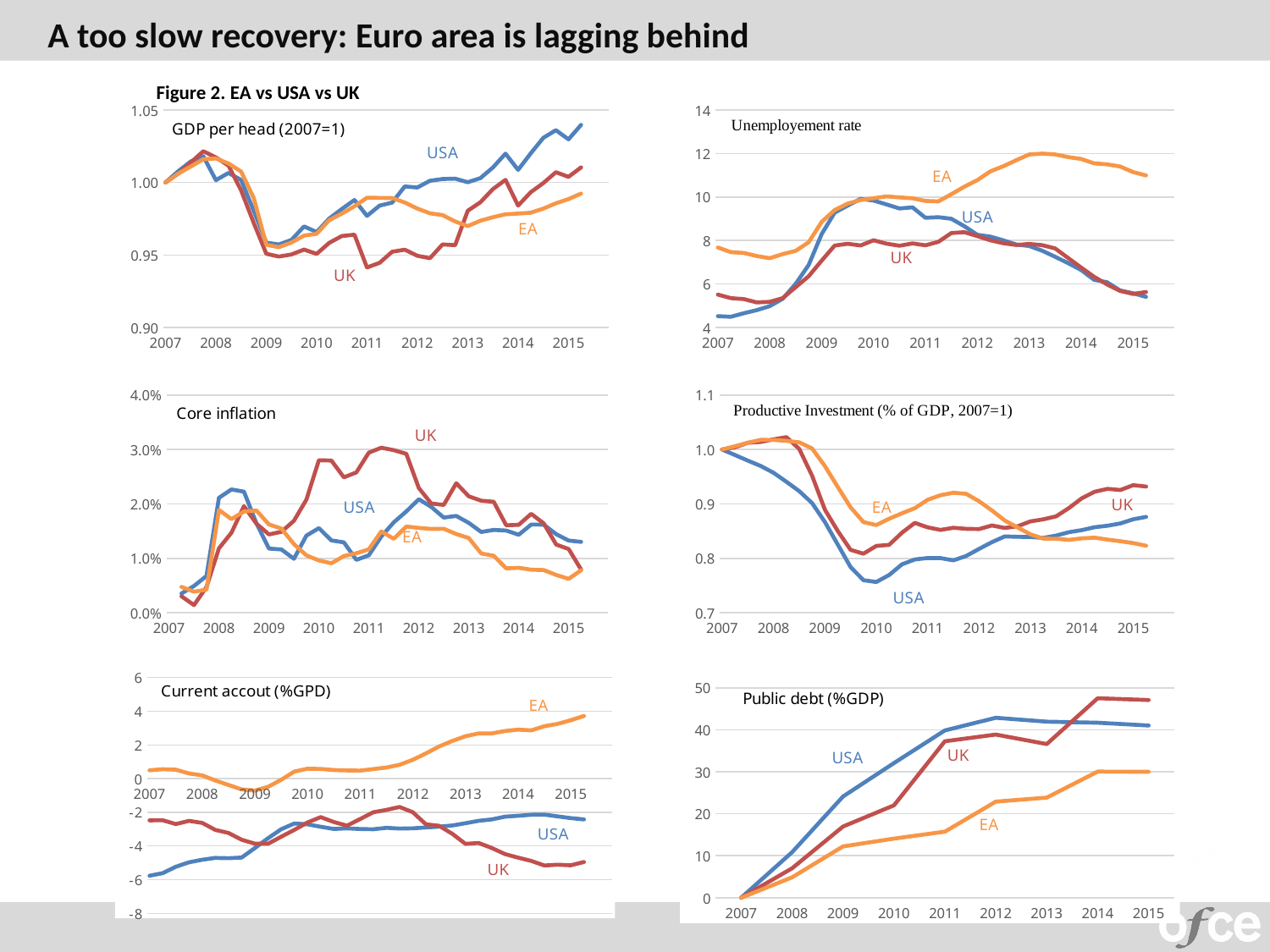
In the 'Unemployement rate' chart, which series is highest in 2013? EA What kind of chart is the 'GDP per head (2007=1)' chart? line chart In the 'Current accout (%GPD)' chart, is the value for EA in 2015 greater or less than 2? greater In the 'Unemployement rate' chart, is the value for EA in 2013 greater or less than 10? greater In the 'Core inflation' chart, which series reaches the highest peak? UK In the 'Public debt (%GDP)' chart, which series is highest in 2015? UK How many series are plotted in the 'GDP per head (2007=1)' chart? 3 In the 'Productive Investment (% of GDP, 2007=1)' chart, is the value for USA in 2010 greater or less than 0.8? less In the 'Current accout (%GPD)' chart, which series is lowest in 2015? UK In the 'Public debt (%GDP)' chart, does the EA series rise or fall from 2007 to 2015? rises